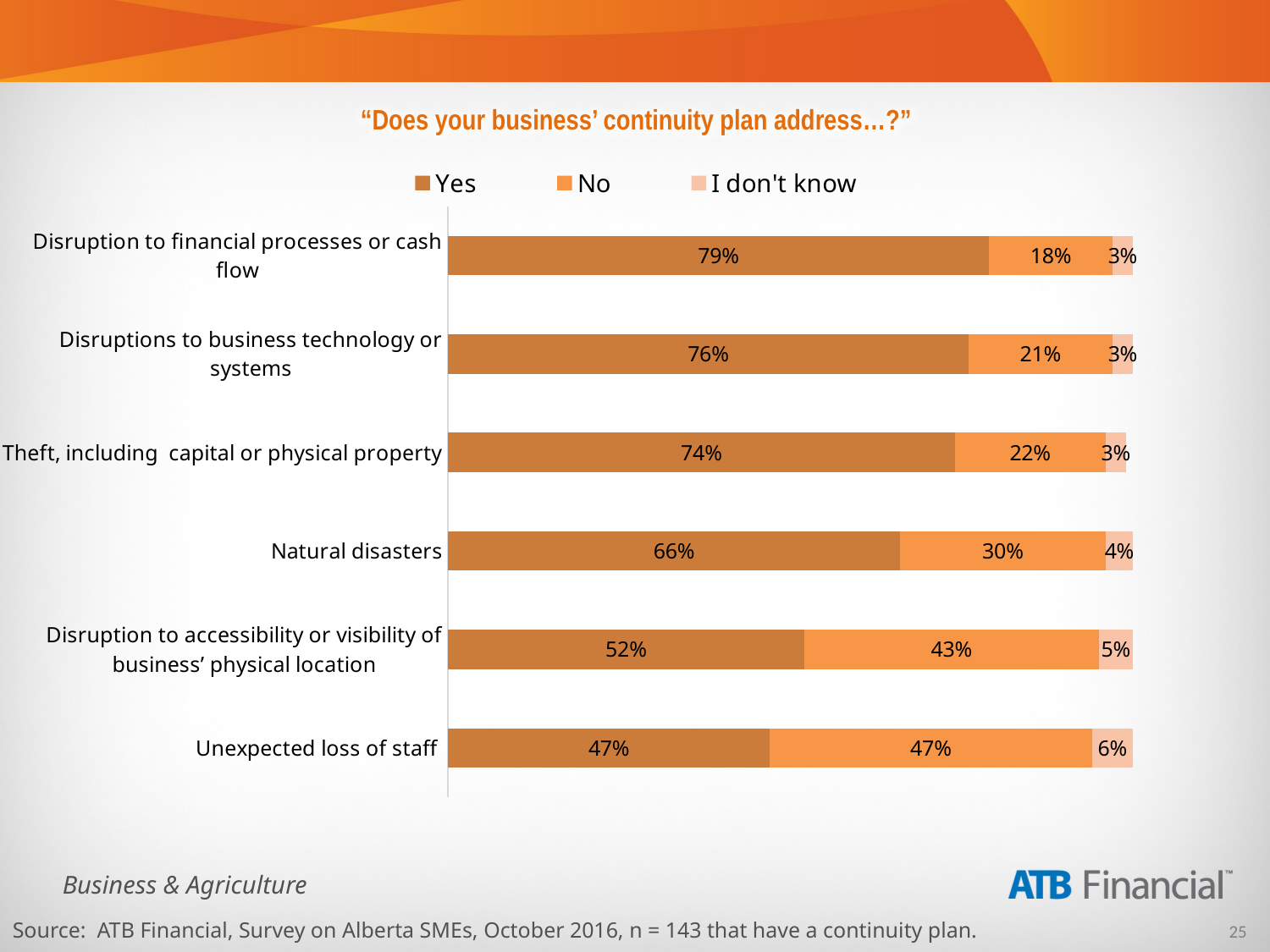
Which is larger: the "No" percentage for "Natural disasters" or the "No" percentage for "Theft, including capital or physical property"? Natural disasters What kind of chart is shown on the slide? Stacked bar chart What is the total of the stacked bar for "Disruptions to business technology or systems"? 100% What percentage of respondents answered "No" for "Disruption to accessibility or visibility of business' physical location"? 43% How many categories are shown in the chart? 6 Which category has the highest "Yes" percentage? Disruption to financial processes or cash flow What percentage of respondents answered "I don't know" for "Unexpected loss of staff"? 6% What is the difference between the "Yes" percentages for "Disruption to financial processes or cash flow" and "Natural disasters"? 13% How many series does the legend list? 3 Which category has the lowest "Yes" percentage? Unexpected loss of staff What is the title of the chart? "Does your business' continuity plan address…?" What percentage of respondents answered "Yes" for "Natural disasters"? 66%